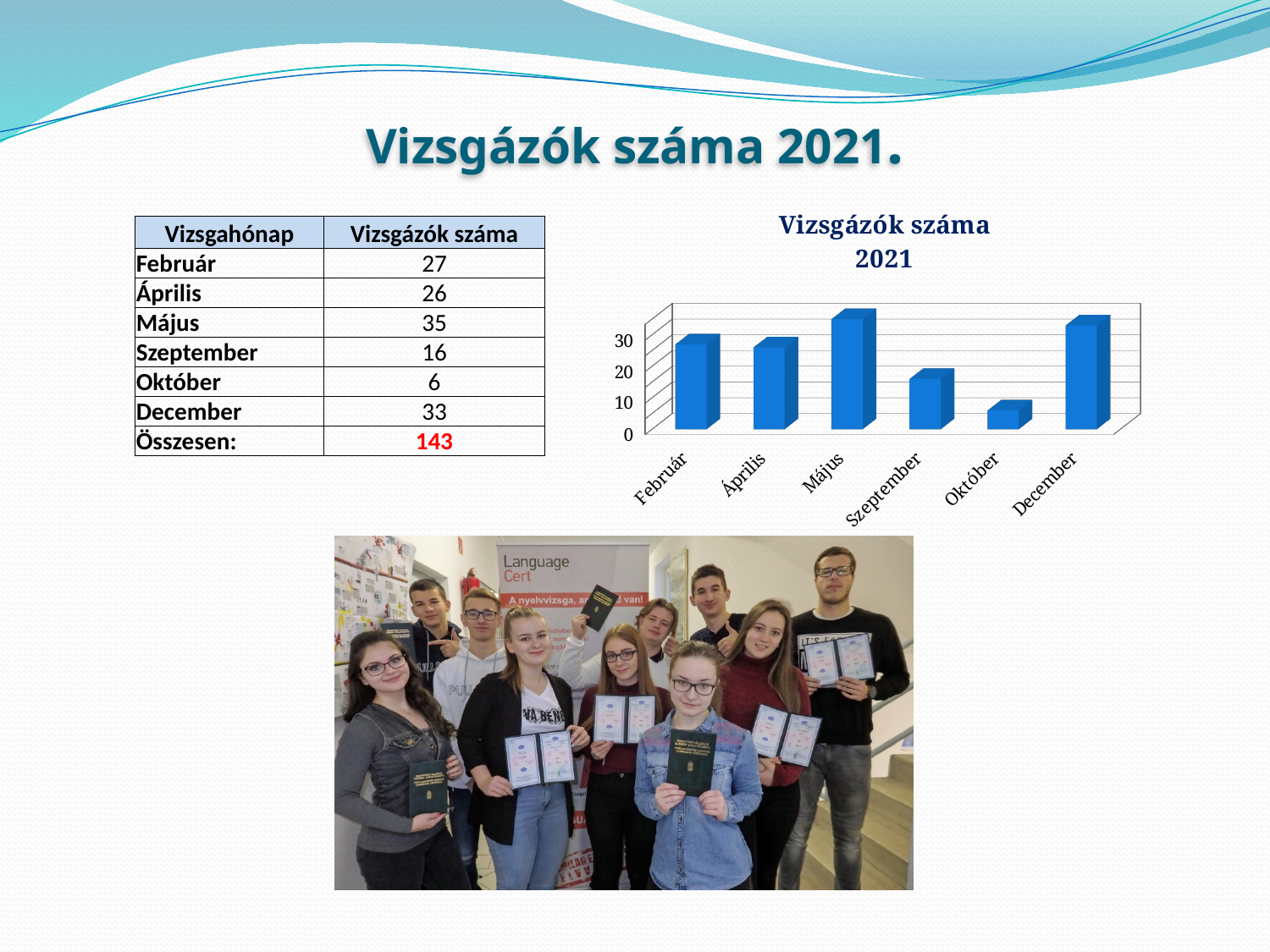
What kind of chart is shown on the slide? bar chart Is the value for Október greater or less than 10? less Which month has the lowest number of examinees in the chart? Október How many months (categories) are shown on the chart's x axis? 6 What is the title of the chart? Vizsgázók száma 2021 Which is larger, the value for December or the value for Szeptember? December What is the difference between the number of examinees in December and in Október, as given on the slide? 27 According to the slide, how many examinees were there in Február? 27 Is the value for Szeptember greater or less than 20? less According to the slide, how many examinees were there in Május? 35 Is the value for Május greater or less than 30? greater Which month has the highest number of examinees (vizsgázók) in the chart? Május